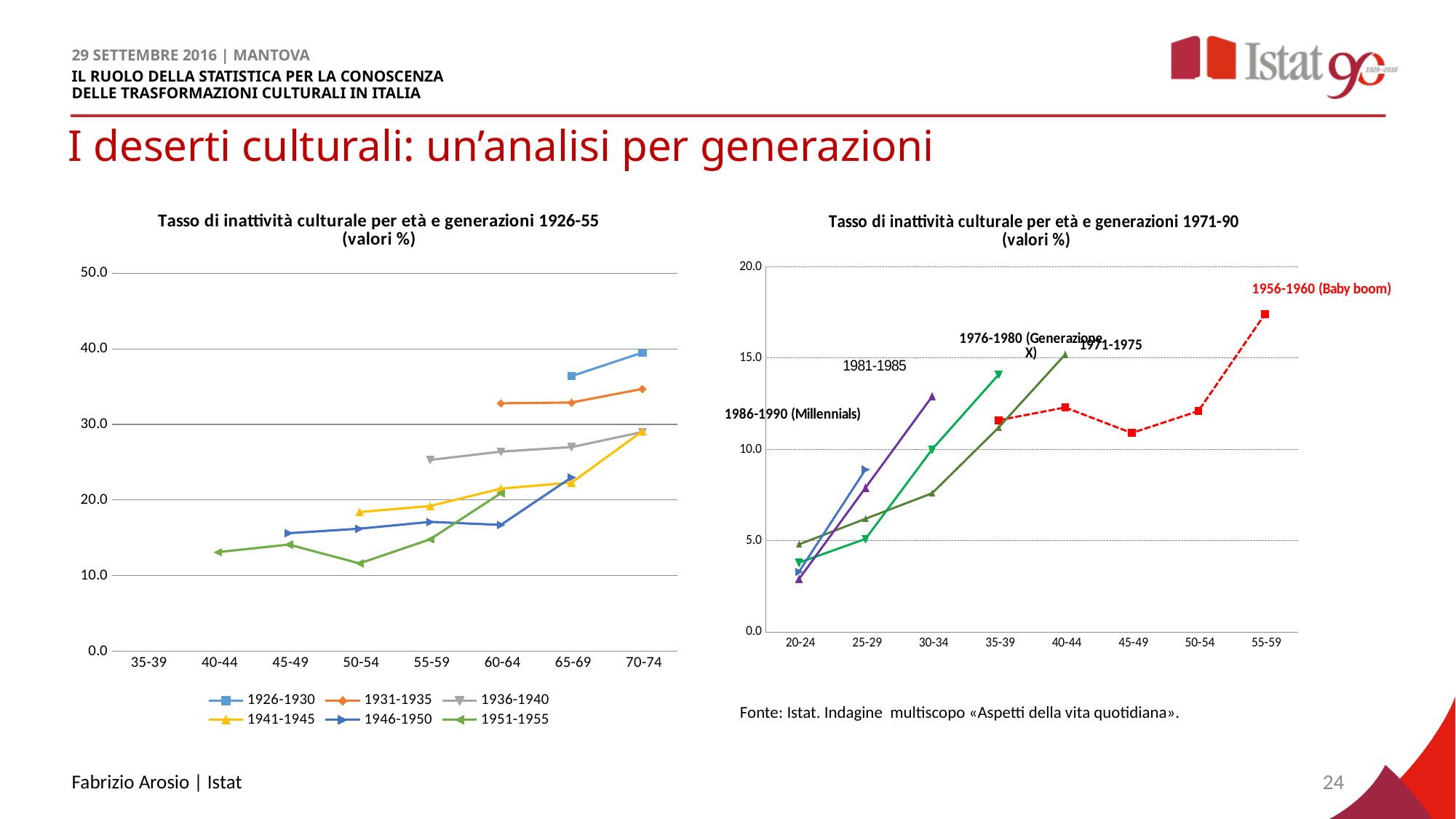
In the left chart (generazioni 1926-55), at 65-69, which series has the larger value: 1926-1930 or 1931-1935? 1926-1930 How many age-group categories are shown on the x axis of the left chart (generazioni 1926-55)? 8 What kind of chart is the left chart, 'Tasso di inattività culturale per età e generazioni 1926-55'? Line chart In the right chart (generazioni 1971-90), is the value for the 1956-1960 (Baby boom) series at 55-59 greater or less than 15? greater How many series does the legend of the left chart (generazioni 1926-55) list? 6 In the left chart (generazioni 1926-55), is the value for the 1926-1930 series at 70-74 greater or less than 30? greater What kind of chart is the right chart, 'Tasso di inattività culturale per età e generazioni 1971-90'? Line chart In the left chart (generazioni 1926-55), which series has the highest value at 70-74? 1926-1930 In the right chart (generazioni 1971-90), is the value for the 1976-1980 (Generazione X) series at 35-39 greater or less than 10? greater In the left chart (generazioni 1926-55), does the 1926-1930 series rise or fall from 65-69 to 70-74? rise In the right chart (generazioni 1971-90), which series reaches the highest value on the chart? 1956-1960 (Baby boom)